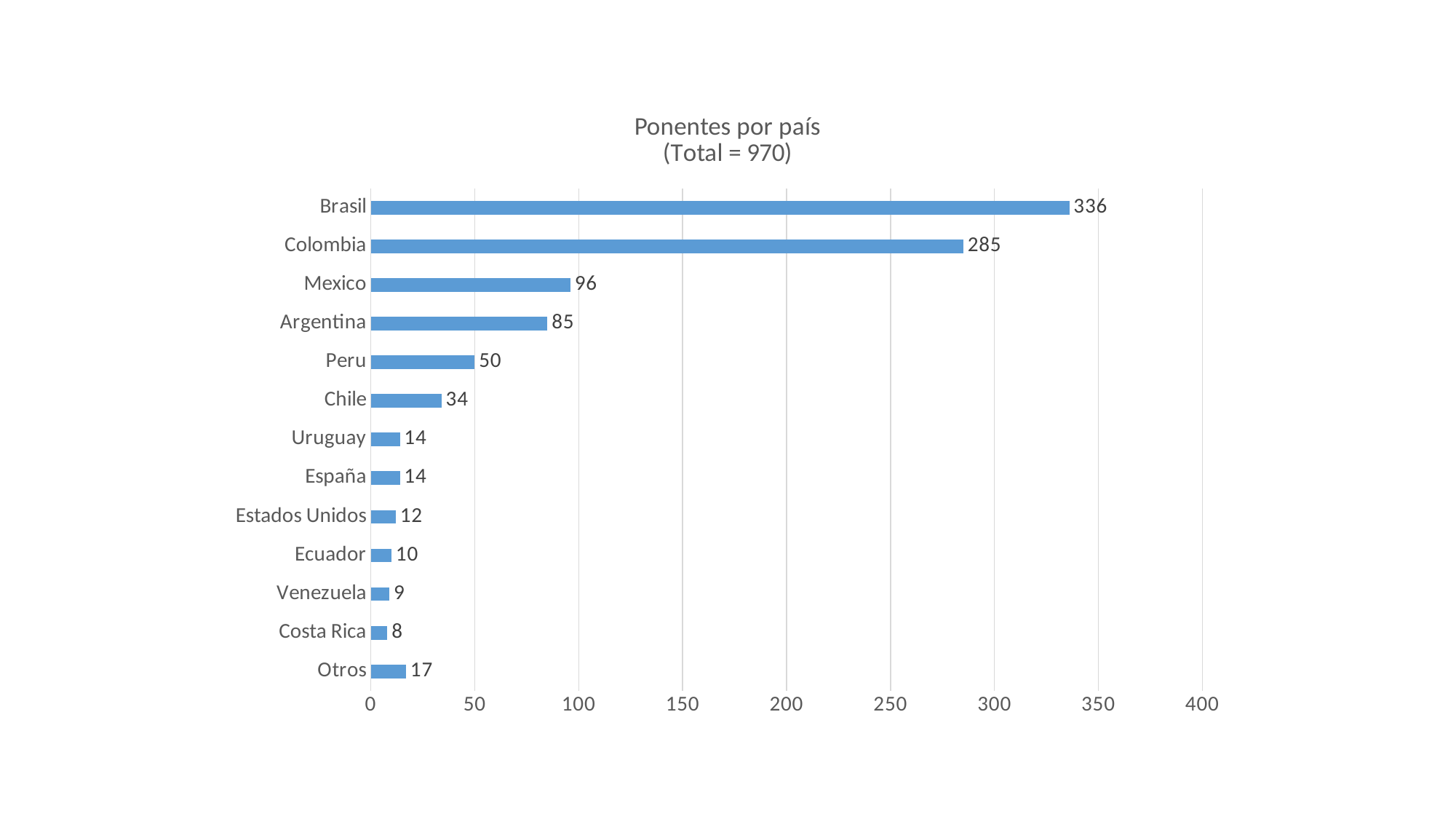
What is the difference between the values for Mexico and Argentina? 11 Which country has the highest number of ponentes? Brasil What is the value for Peru? 50 What is the title of the chart? Ponentes por país (Total = 970) What is the value for Colombia? 285 What kind of chart is shown? Bar chart Which category has the lowest value? Costa Rica Which is larger, the value for Chile or the value for Otros? Chile What is the value for Estados Unidos? 12 What is the difference between the values for Brasil and Colombia? 51 How many categories are shown in the chart? 13 What is the value for Brasil? 336